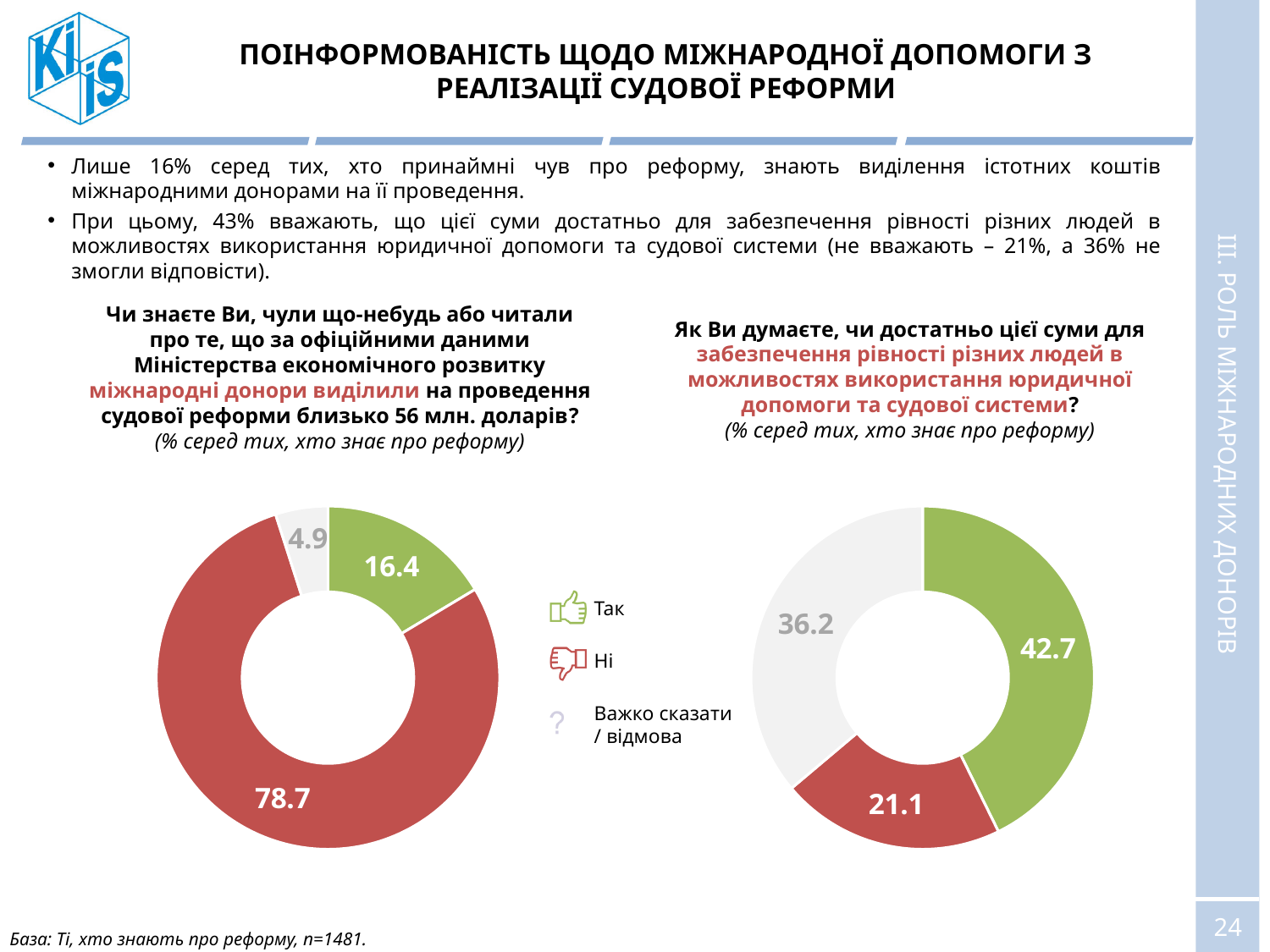
In the right donut chart, which is larger: the value for "Так" or the value for "Важко сказати / відмова"? Так In the left donut chart, what is the value for "Ні"? 78.7 In the left donut chart, which category has the largest share? Ні In the right donut chart, which category has the smallest share? Ні In the right donut chart, what is the value for "Важко сказати / відмова"? 36.2 In the left donut chart, what is the value for "Важко сказати / відмова"? 4.9 In the right donut chart, what is the value for "Так"? 42.7 What type of chart is used on this slide? Donut (pie) chart In the left donut chart, what is the difference between the values for "Ні" and "Так"? 62.3 In the right donut chart, what is the value for "Ні"? 21.1 How many categories does the shared legend list? 3 In the left donut chart, what is the value for "Так"? 16.4